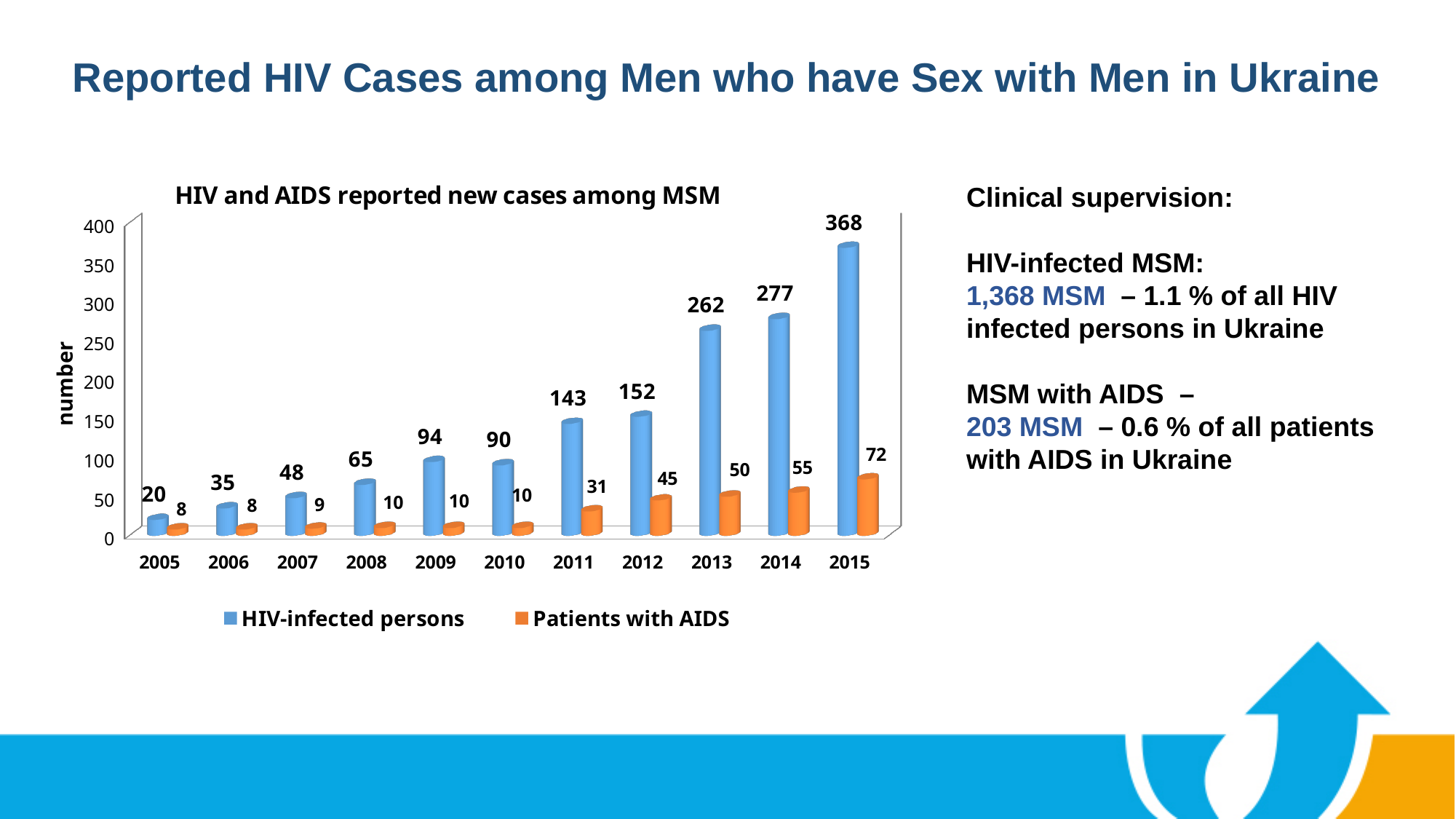
Do the values for patients with AIDS generally rise or fall from 2005 to 2015? Rise Which is larger: HIV-infected persons in 2009 or in 2010? 2009 How many years are shown on the x axis of the chart? 11 What is the number of HIV-infected persons reported in 2015? 368 How many patients with AIDS were reported in 2011? 31 What is the title of the chart? HIV and AIDS reported new cases among MSM What kind of chart is shown on the slide? Bar chart What is the value for HIV-infected persons in 2009? 94 Which year has the highest number of HIV-infected persons? 2015 What is the difference between HIV-infected persons in 2014 and 2013? 15 Which year has the lowest number of HIV-infected persons? 2005 How many series does the chart legend list? 2